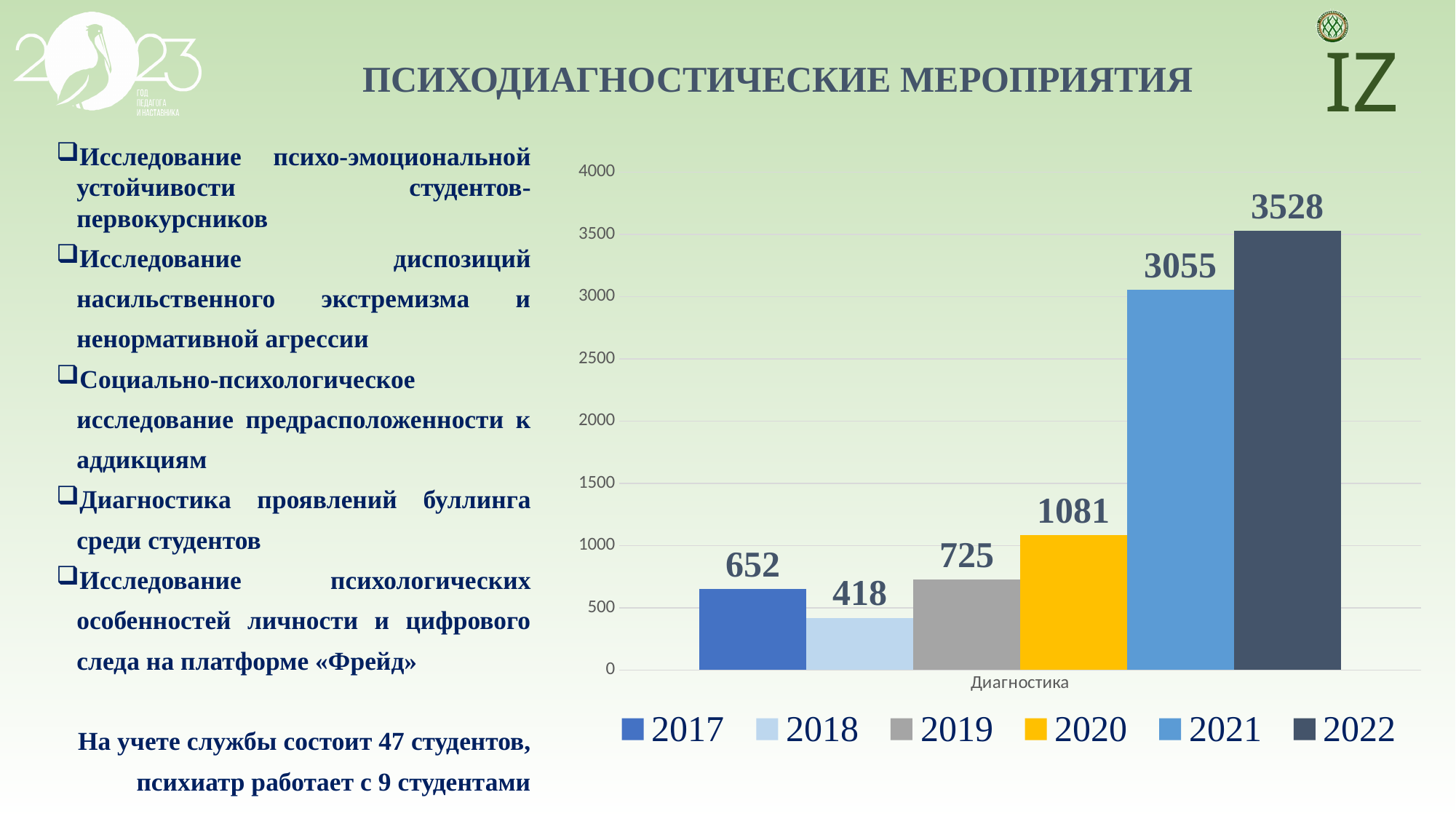
What is the value for 2020 in the chart? 1081 Which year has the lowest value in the chart? 2018 Which is larger, the value for 2019 or the value for 2017? 2019 What is the value for 2017 in the chart? 652 What is the difference between the values for 2022 and 2021? 473 How many series does the legend list? 6 What is the difference between the values for 2019 and 2018? 307 What is the category label shown on the x axis of the chart? Диагностика Is the value for 2021 greater or less than 3000? greater What kind of chart is shown on the slide? bar chart What is the value for 2022 in the chart? 3528 Which year has the highest value in the chart? 2022